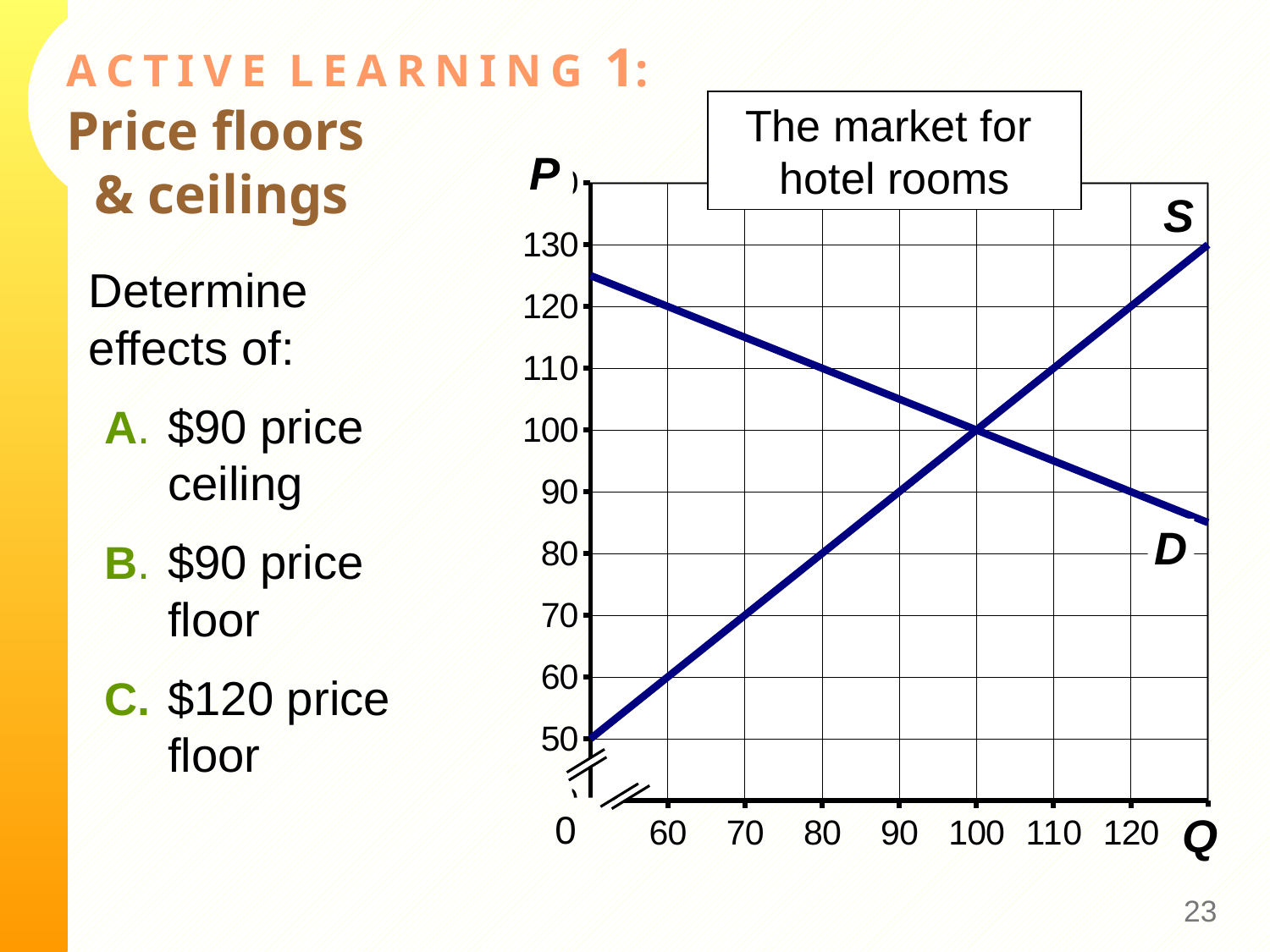
What is the price on the S curve when Q is 120? 120 At what quantity do the S and D curves intersect? 100 What kind of chart is shown on the slide? line chart What is the price on the S curve when Q is 60? 60 What is the price on the D curve when Q is 80? 110 What is the title of the chart? The market for hotel rooms How many curves are plotted on the chart? 2 At Q = 70, which curve has the higher price, S or D? D At what price do the S and D curves intersect? 100 What is the price on the D curve when Q is 60? 120 Does the S curve rise or fall as Q increases? rise Does the D curve rise or fall as Q increases? fall